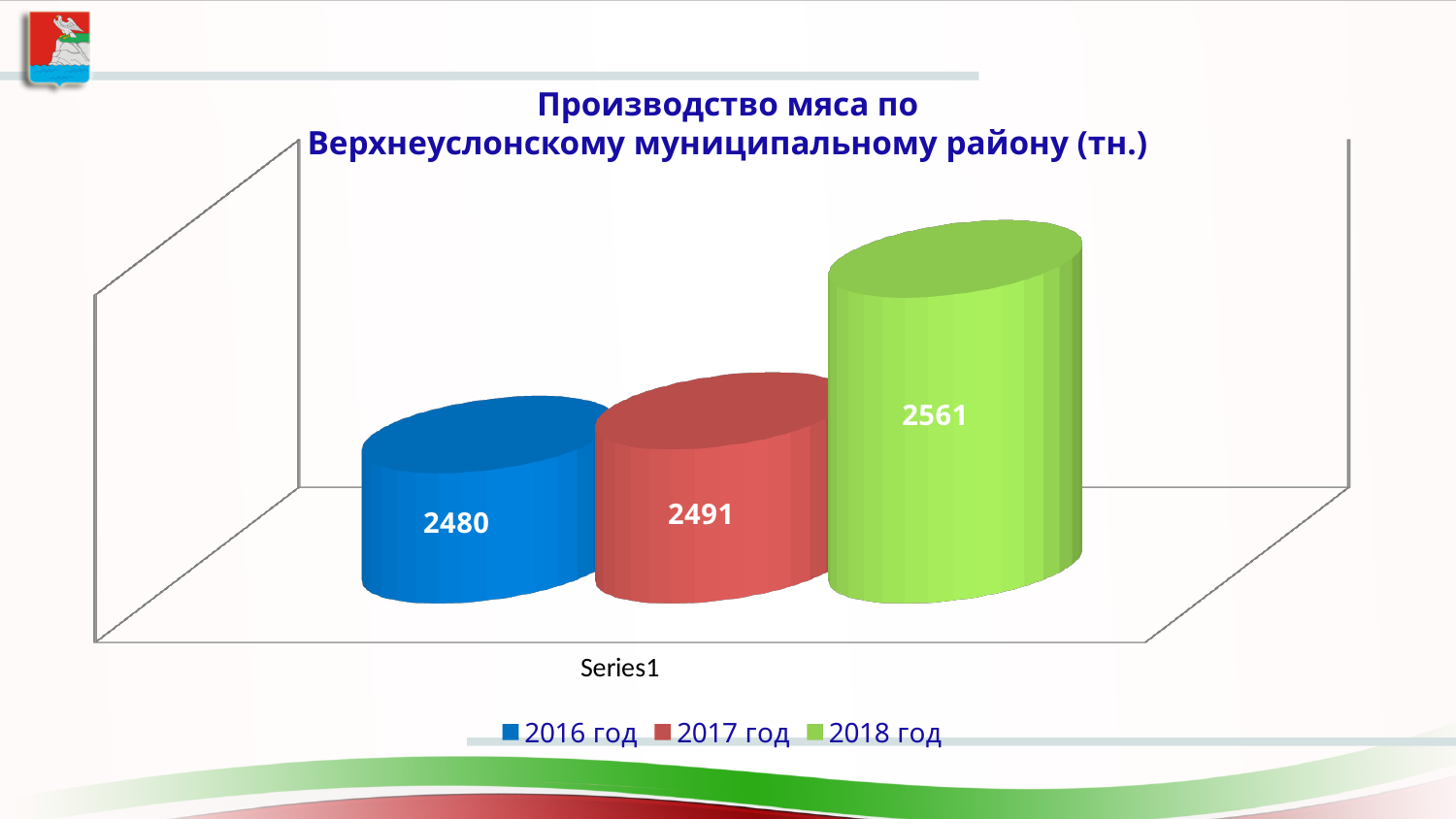
What is the difference between the values for 2017 год and 2016 год? 11 Which year has the lowest meat production? 2016 год What kind of chart is shown on the slide? bar chart What is the difference between the values for 2018 год and 2016 год? 81 Which year has the highest meat production? 2018 год How many series does the legend list? 3 Do the values rise or fall from 2016 год to 2018 год? rise What is the value for 2016 год? 2480 What is the value for 2018 год? 2561 What colour is the bar for 2018 год? green Which is larger, the value for 2018 год or the value for 2017 год? 2018 год What is the value for 2017 год? 2491